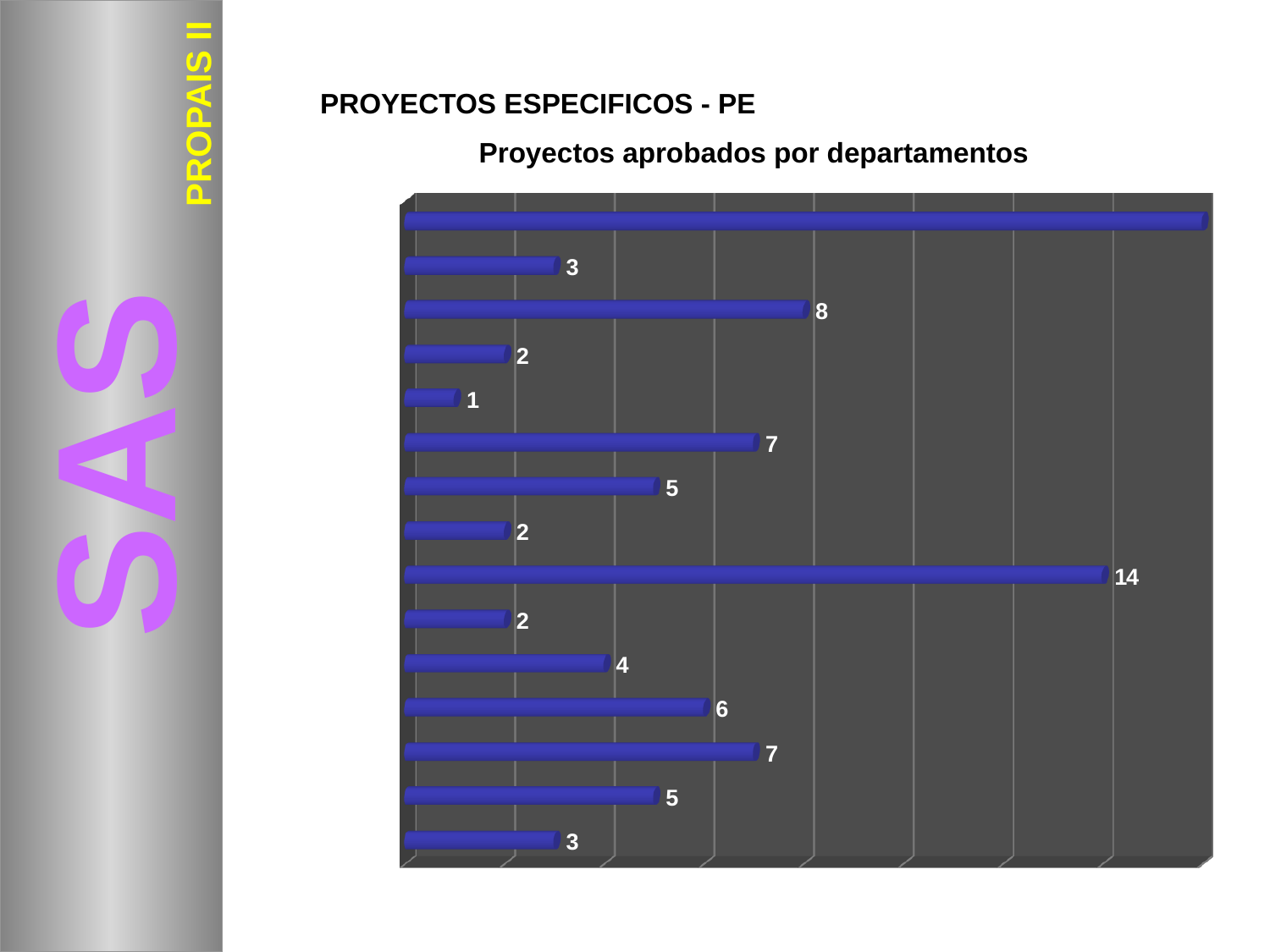
What is the difference between the largest labelled value (14) and the smallest labelled value (1)? 13 What is the value of the fifth bar from the top? 1 Which is larger, the third bar from the top (8) or the sixth bar from the top (7)? the third bar from the top (8) What is the largest value printed as a data label on the chart? 14 How many bars have a data label of 2? 3 How many bars are plotted in the chart? 15 What kind of chart is shown on the slide? bar chart What is the value of the bottom bar in the chart? 3 What is the title of the chart? Proyectos aprobados por departamentos What is the smallest value printed as a data label on the chart? 1 What is the value of the third bar from the top? 8 Which bar is the longest in the chart? the top bar